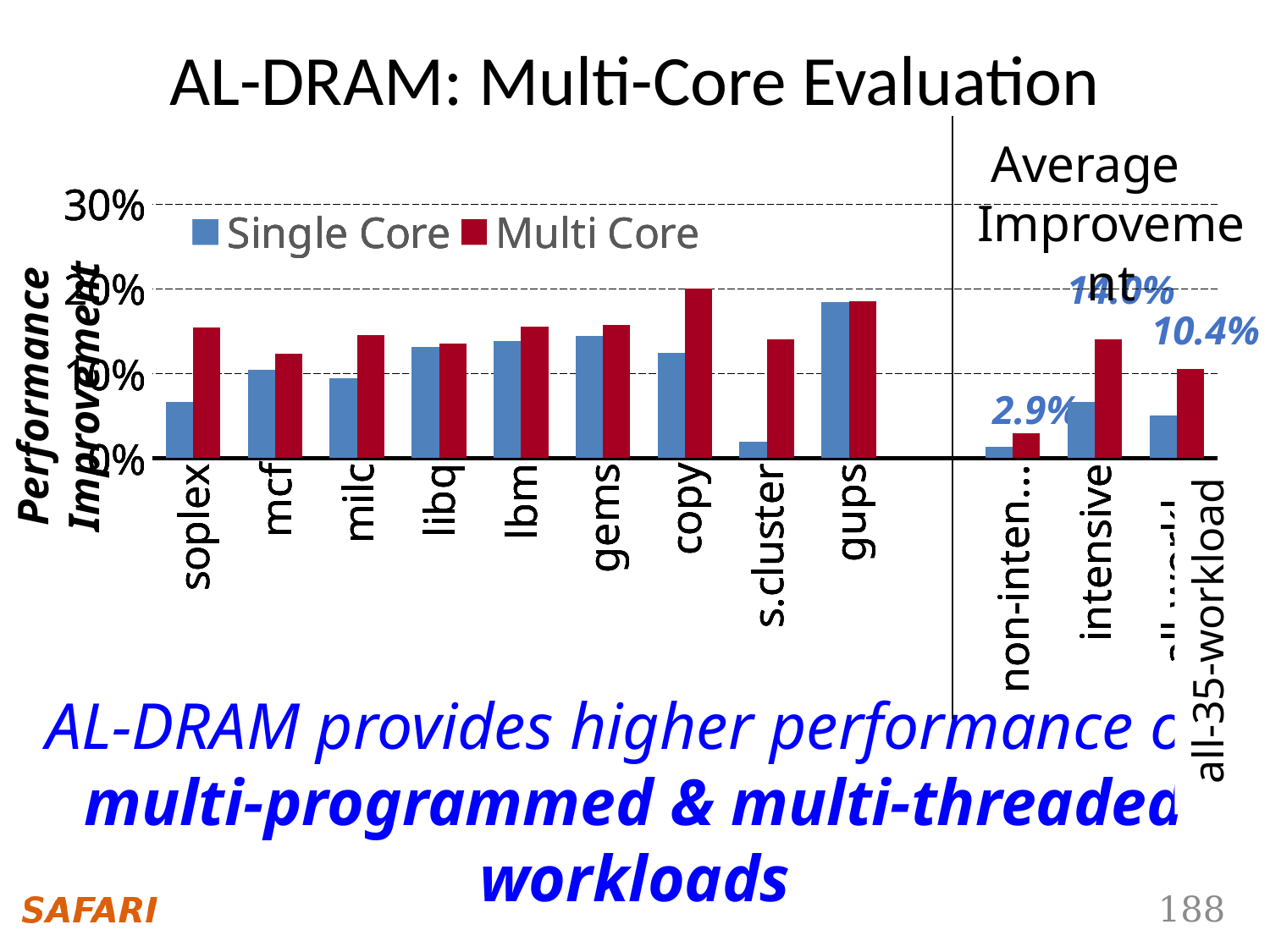
How many individual benchmarks are plotted to the left of the vertical divider line? 9 How many series does the legend list? 2 What kind of chart is shown on the slide? bar chart Which benchmark has the highest Single Core performance improvement? gups What are the two series named in the legend? Single Core and Multi Core Is the Multi Core value for copy greater or less than 10%? greater Is the Single Core value for s.cluster greater or less than 10%? less Among the nine individual benchmarks, which has the lowest Single Core performance improvement? s.cluster What is the Multi Core average performance improvement labelled for the all-workload category? 10.4% Which benchmark has the highest Multi Core performance improvement? copy What is the Multi Core average performance improvement labelled for the non-intensive (non-inten...) workloads? 2.9% For soplex, which is larger: the Single Core or the Multi Core performance improvement? Multi Core